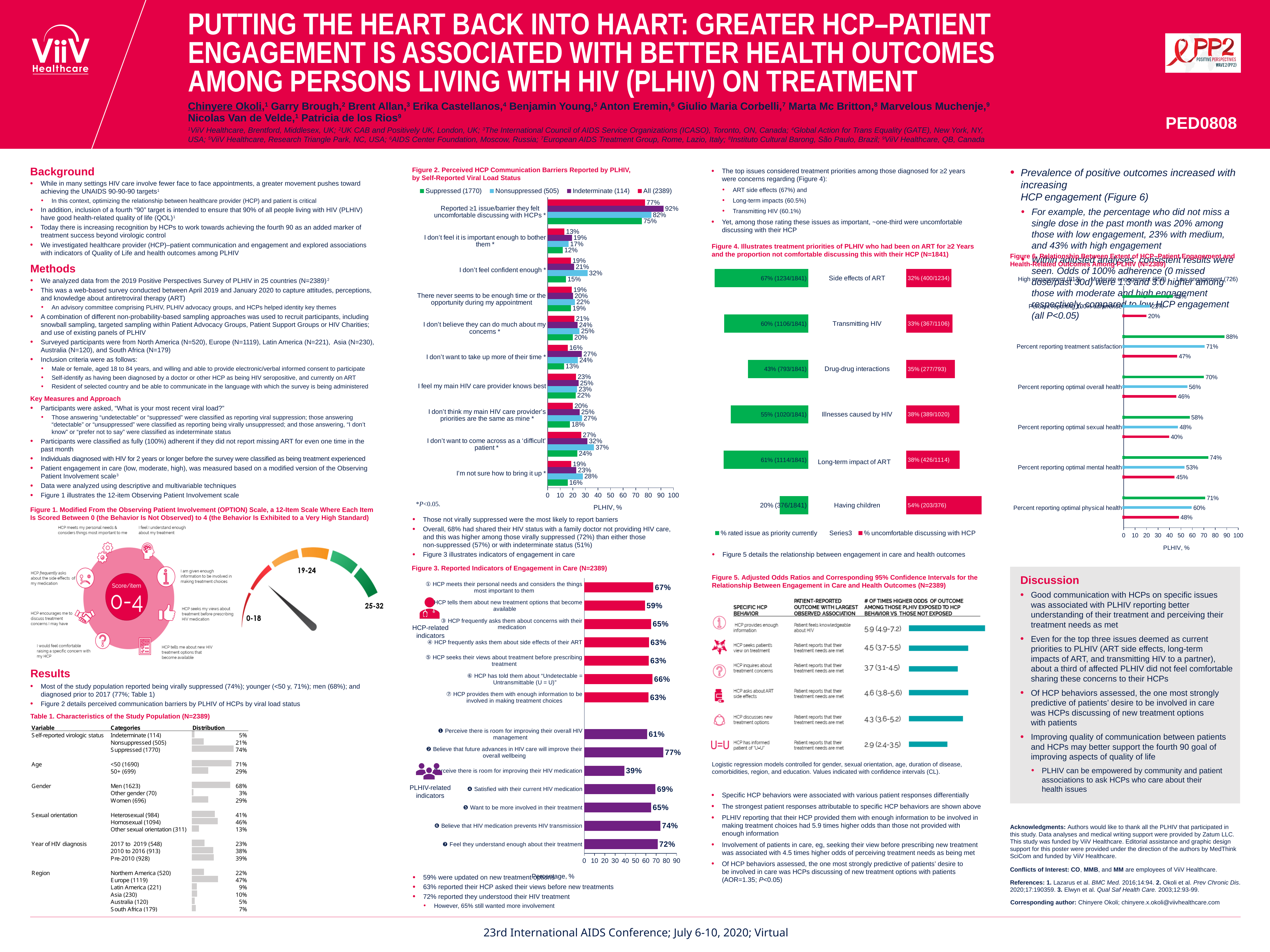
In Figure 3, what percentage believe that future advances in HIV care will improve their overall wellbeing? 77% In Figure 6, what is the difference between high engagement and low engagement for percent reporting optimal mental health? 29% What type of chart is Figure 3? Bar chart In Figure 2, what is the difference between the Nonsuppressed and Suppressed values for 'I don't feel confident enough'? 17% In Figure 4, which issue has the highest percentage rated as a priority currently? Side effects of ART In Figure 2, what percentage of all respondents (All, 2389) reported ≥1 issue/barrier they felt uncomfortable discussing with HCPs? 77% In Figure 3, which indicator has the lowest percentage? Perceive there is room for improving their HIV medication In Figure 3, what percentage reported that their HCP has told them about 'Undetectable = Untransmittable (U = U)'? 66% In Figure 6, what percentage of those with high engagement reported treatment satisfaction? 88% In Figure 4, what percentage of PLHIV rated 'Having children' as a priority currently? 20% (376/1841) In Figure 2, how many series does the legend list? 4 In Figure 2, for 'I don't want to come across as a difficult patient', which group has the higher value: Nonsuppressed or Suppressed? Nonsuppressed